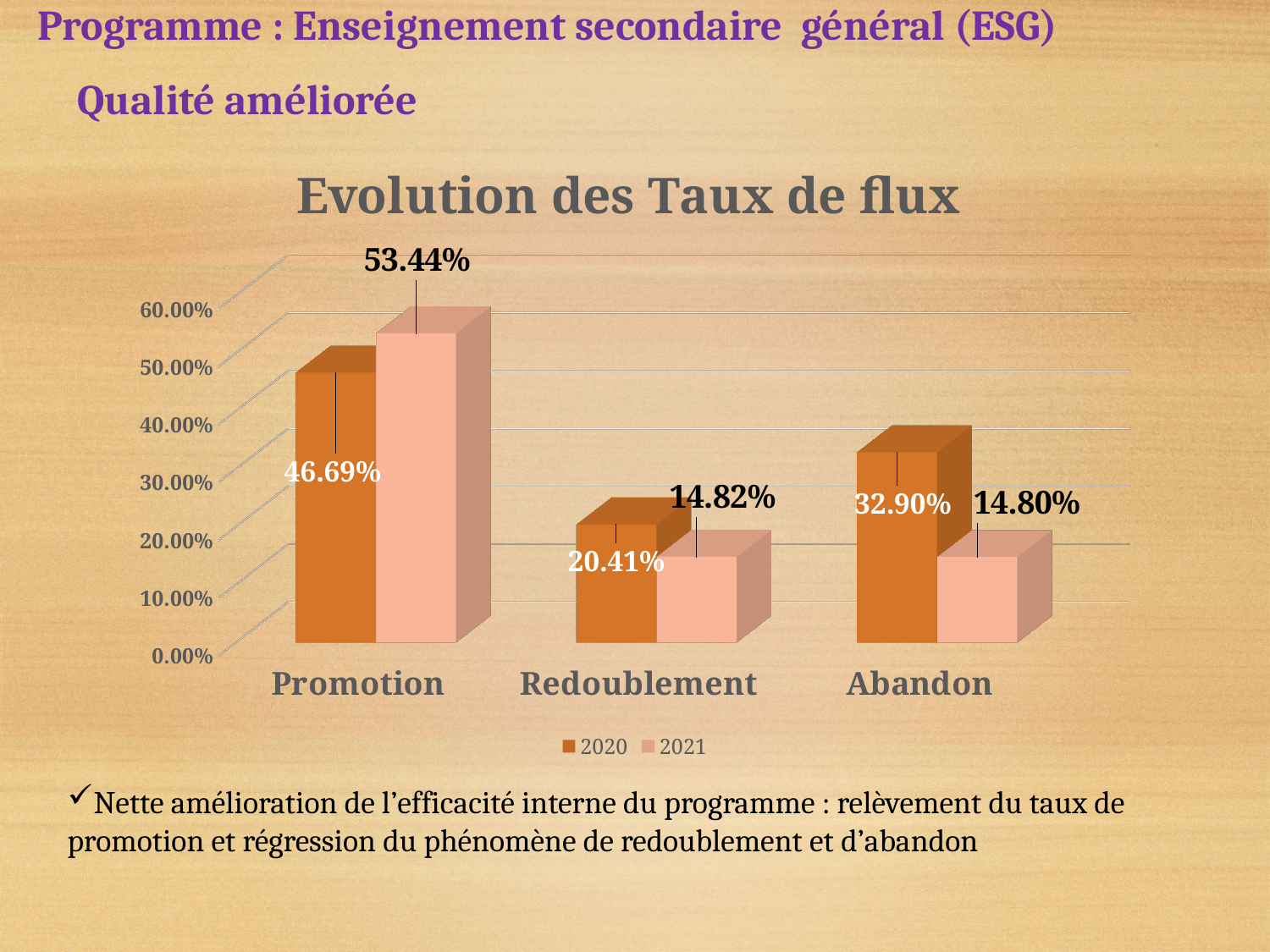
What is the difference between the 2021 and 2020 values for Promotion? 6.75 percentage points Which category has the lowest value in the 2020 series? Redoublement What is the difference between the 2020 and 2021 values for Abandon? 18.10 percentage points What is the value for Abandon in the 2021 series? 14.80% What is the value for Promotion in the 2020 series? 46.69% What is the value for Redoublement in the 2020 series? 20.41% How many series does the legend list? 2 What is the value for Promotion in the 2021 series? 53.44% How many categories are shown on the x axis? 3 What kind of chart is shown on the slide? Bar chart Which category has the highest value in the 2020 series? Promotion Which is larger for Abandon, the 2020 value or the 2021 value? 2020